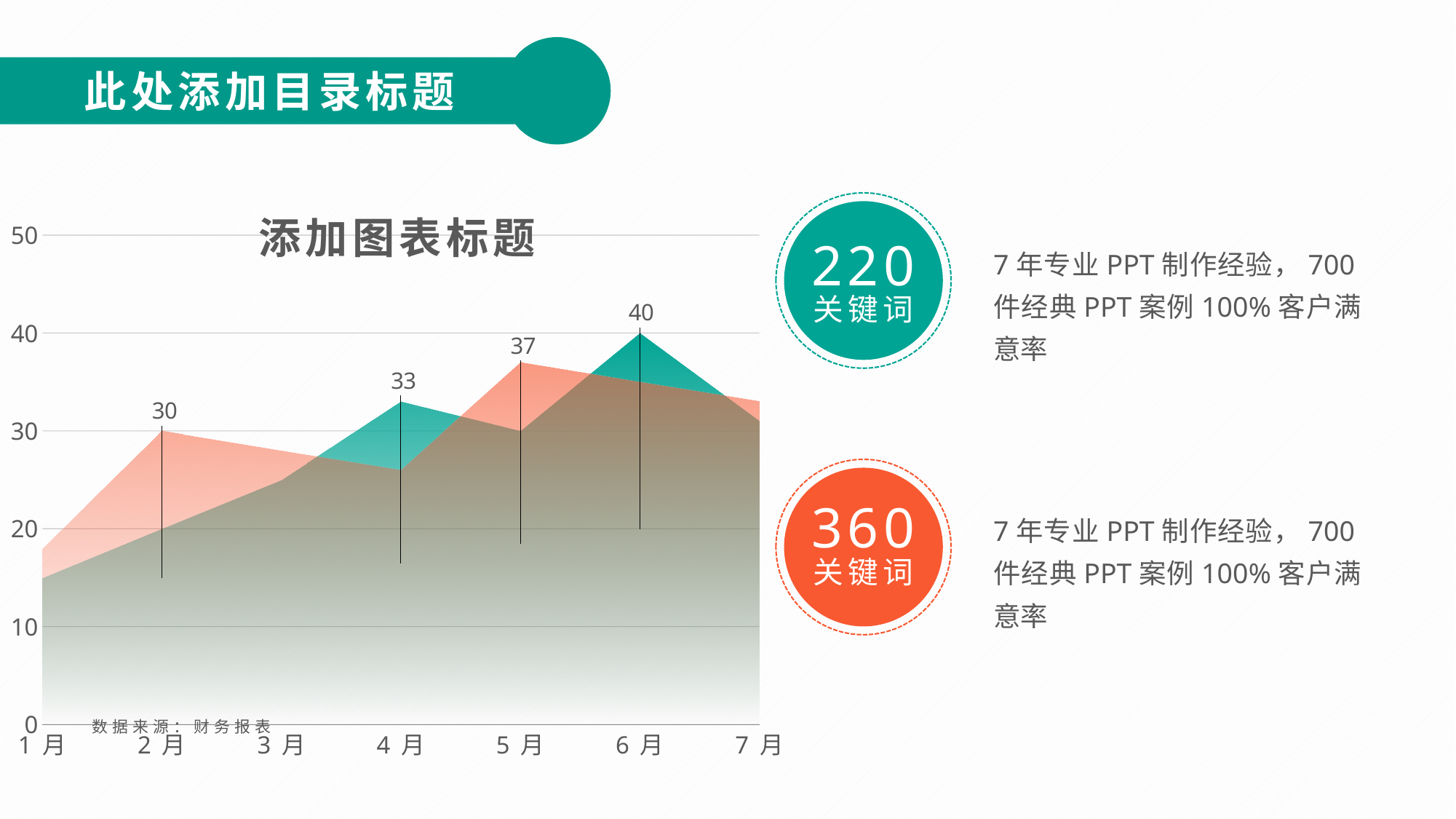
How many months are shown on the x axis of the chart? 7 What is the title of the chart? 添加图表标题 What value is labelled at 4月 on the chart? 33 Which labelled value is larger, the one at 5月 or the one at 4月? 5月 Which month has the highest labelled value on the chart? 6月 What value is labelled at 2月 on the chart? 30 What value is labelled at 5月 on the chart? 37 Are the values plotted at 1月 greater or less than 20? less What is the difference between the labelled values at 6月 and 2月? 10 What kind of chart is shown on the slide? area chart What value is labelled at 6月 on the chart? 40 Which month has the lowest labelled value on the chart? 2月